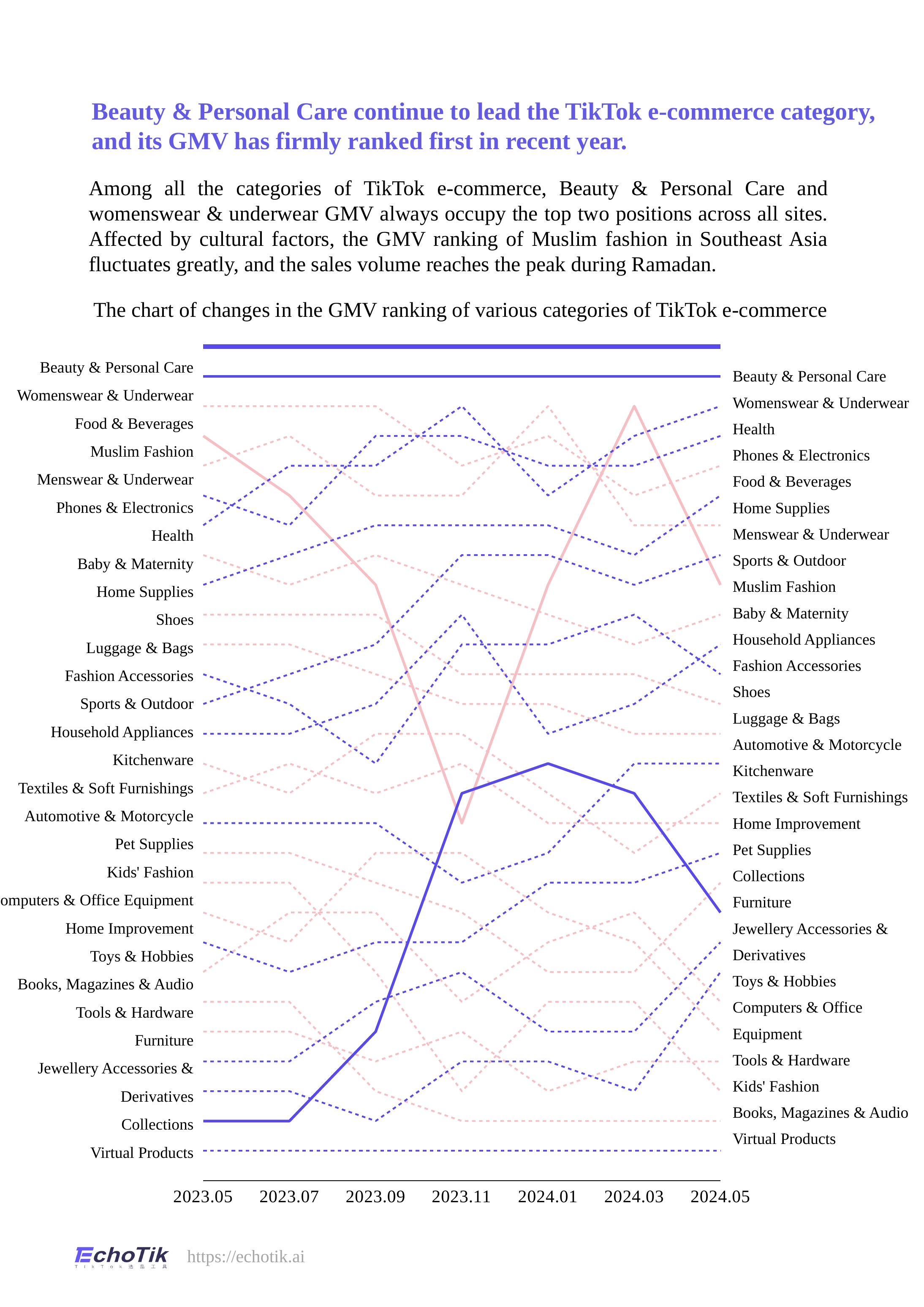
Which category holds the top GMV ranking at 2024.05? Beauty & Personal Care Does Muslim Fashion rank higher or lower at 2024.05 than at 2023.05? Lower Does Collections rank higher or lower at 2024.05 than at 2023.05? Higher How many time points are shown along the x axis of the chart? 7 Which category is ranked third at 2023.05? Food & Beverages Which category is ranked third at 2024.05? Health Which category is ranked second at 2023.05? Womenswear & Underwear What is the title of the chart? The chart of changes in the GMV ranking of various categories of TikTok e-commerce Which category is ranked lowest at 2023.05? Virtual Products Which category ranks higher at 2024.05, Health or Food & Beverages? Health What kind of chart is shown on the slide? Line chart Which category is ranked lowest at 2024.05? Virtual Products